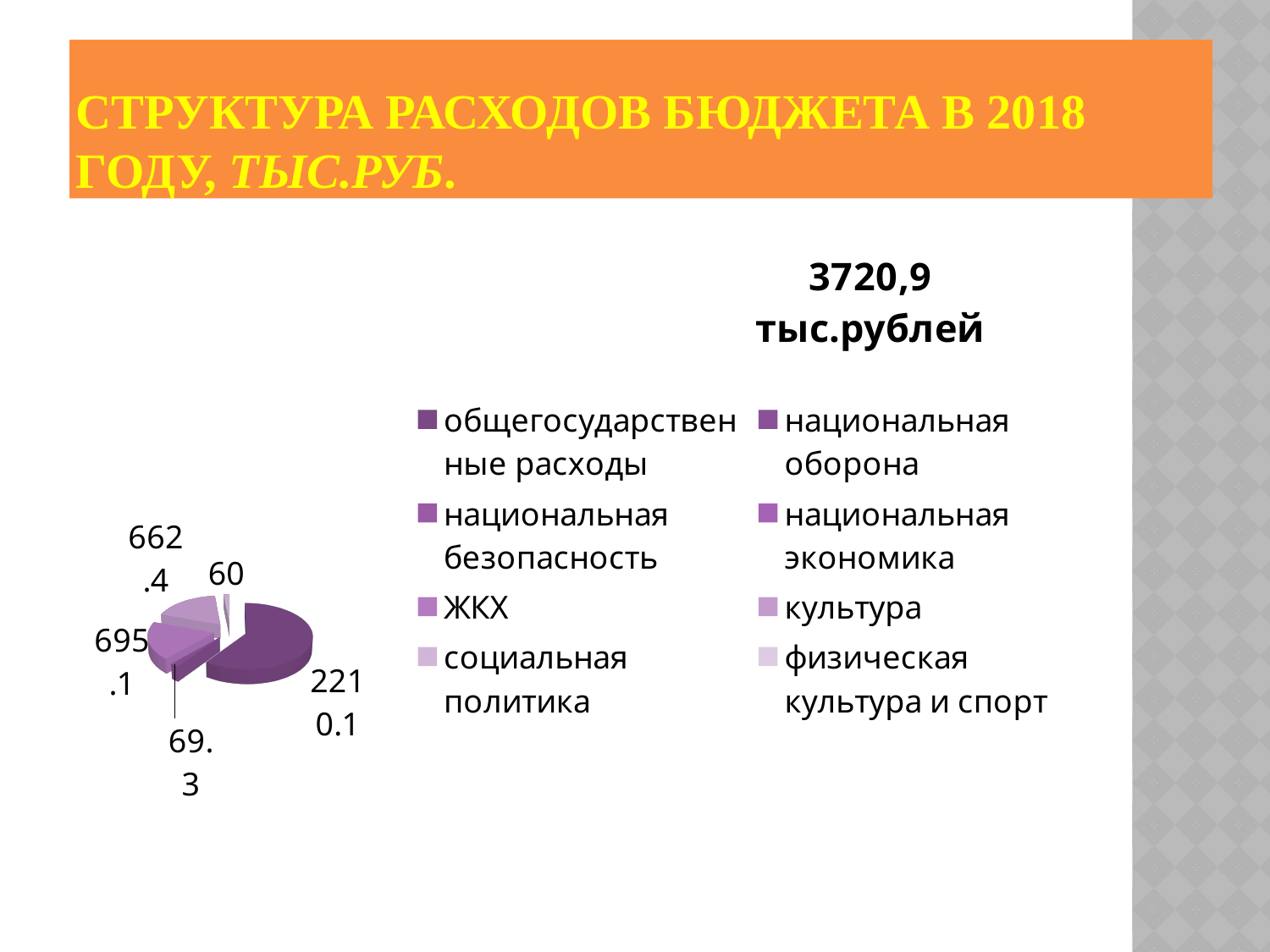
What is the smallest data label printed on the pie chart? 60 Which category has the largest slice in the pie chart? общегосударственные расходы How many categories does the legend of the pie chart list? 8 Which is larger, the slice labelled 695.1 or the slice labelled 662.4? 695.1 What share of the total 3720,9 does the общегосударственные расходы slice (2210.1) represent? 59.4% How many data labels are printed on the pie chart? 5 What is the difference between the slice labelled 695.1 and the slice labelled 662.4? 32.7 What is the title shown above the pie chart's legend? 3720,9 тыс.рублей What is the value of the slice for общегосударственные расходы? 2210.1 What kind of chart is shown on the slide? pie chart How much larger is the largest slice (2210.1) than the slice labelled 695.1? 1515 What is the title of the slide? Структура расходов бюджета в 2018 году, тыс.руб.